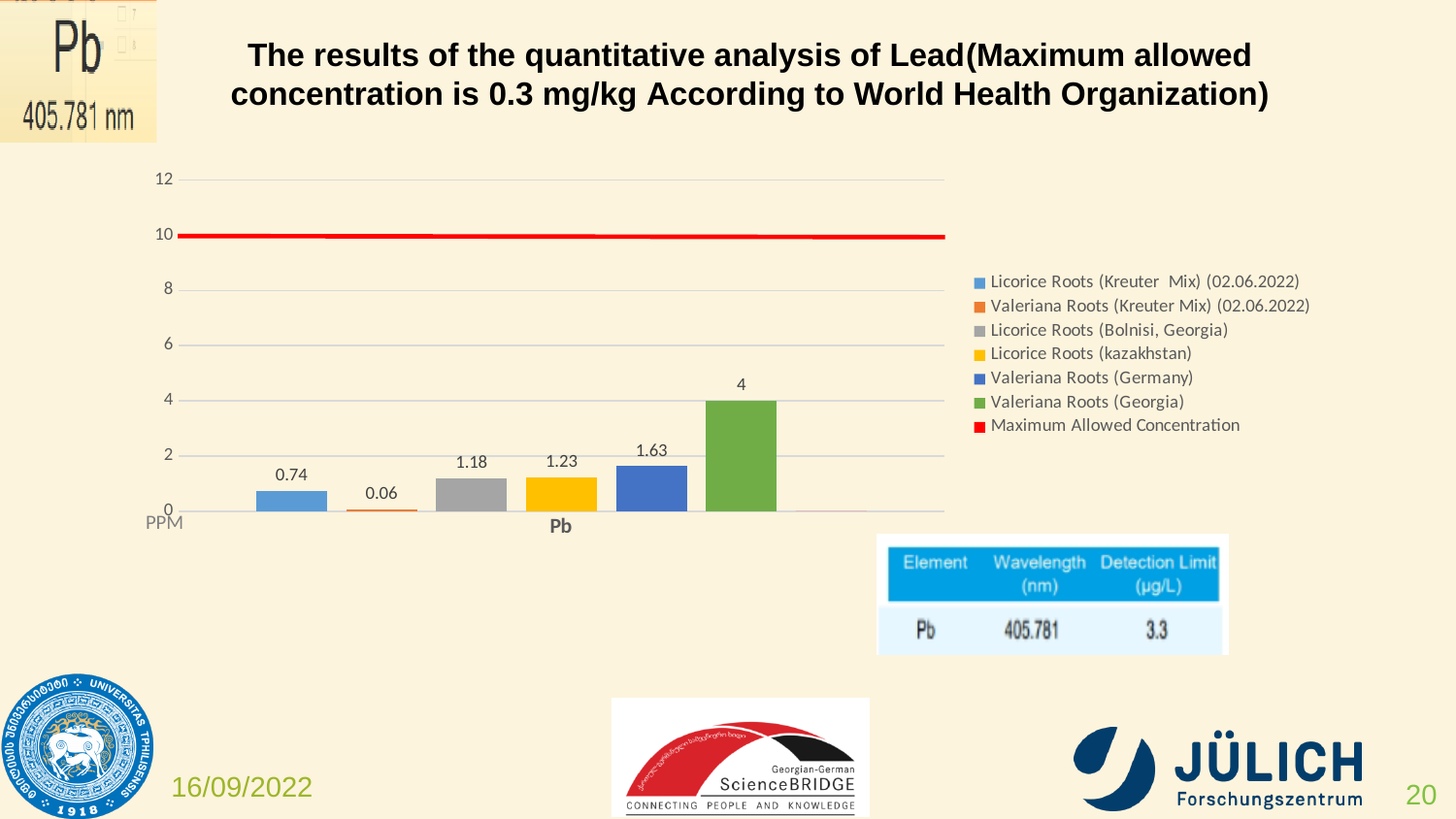
Which is larger, the value for Licorice Roots (Bolnisi, Georgia) or the value for Licorice Roots (Kreuter Mix) (02.06.2022)? Licorice Roots (Bolnisi, Georgia) What kind of chart is shown on the slide? bar chart What is the value for Licorice Roots (Bolnisi, Georgia)? 1.18 What is the category label shown on the x axis of the chart? Pb What is the value for Valeriana Roots (Kreuter Mix) (02.06.2022)? 0.06 What is the value for Valeriana Roots (Georgia)? 4 Is the Maximum Allowed Concentration line greater or less than 8 on the axis? greater What is the value for Licorice Roots (Kreuter Mix) (02.06.2022)? 0.74 What is the difference between the values for Valeriana Roots (Germany) and Licorice Roots (kazakhstan)? 0.4 How many entries does the legend list? 7